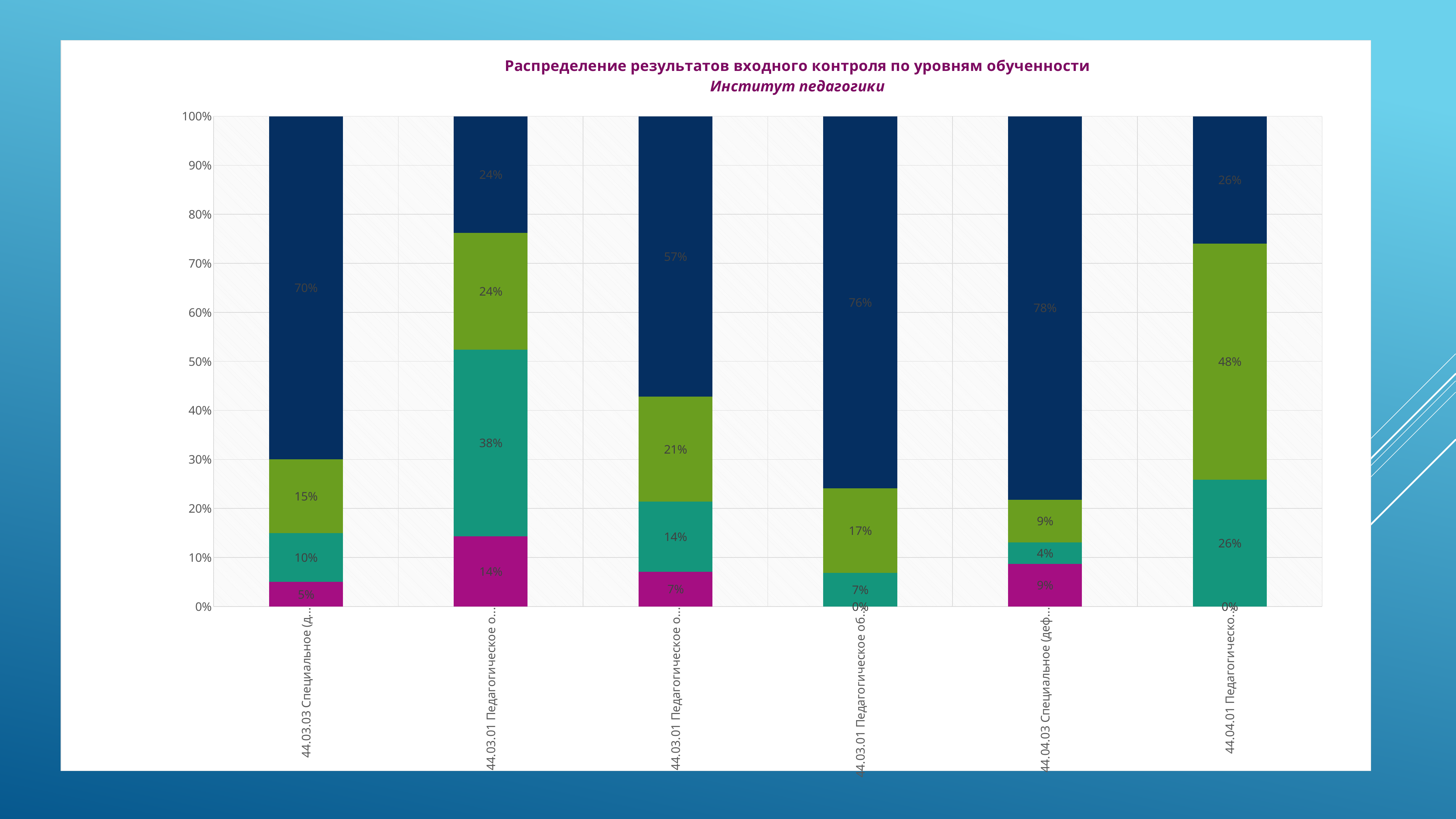
Which bar has the smallest dark blue (top) segment? the second bar from the left (44.03.01 Педагогическое...), 24% What is the total of the stacked segments in the first bar (5%, 10%, 15%, 70%)? 100% Which bar has the largest dark blue (top) segment? the fifth bar from the left (44.04.03 Специальное...), 78% What is the value of the magenta (bottom) segment of the fifth bar from the left? 9% What is the title of the chart? Распределение результатов входного контроля по уровням обученности. Институт педагогики Which is larger: the green segment of the second bar or the green segment of the third bar? the green segment of the second bar (24%) What is the value of the teal segment of the second bar from the left? 38% What kind of chart is shown on the slide? stacked bar chart What is the value of the dark blue (top) segment of the first bar from the left? 70% How many bars (categories) are plotted in the chart? 6 What is the difference between the dark blue segment of the fourth bar (76%) and the dark blue segment of the third bar (57%)? 19% What is the value of the green segment of the sixth (rightmost) bar? 48%